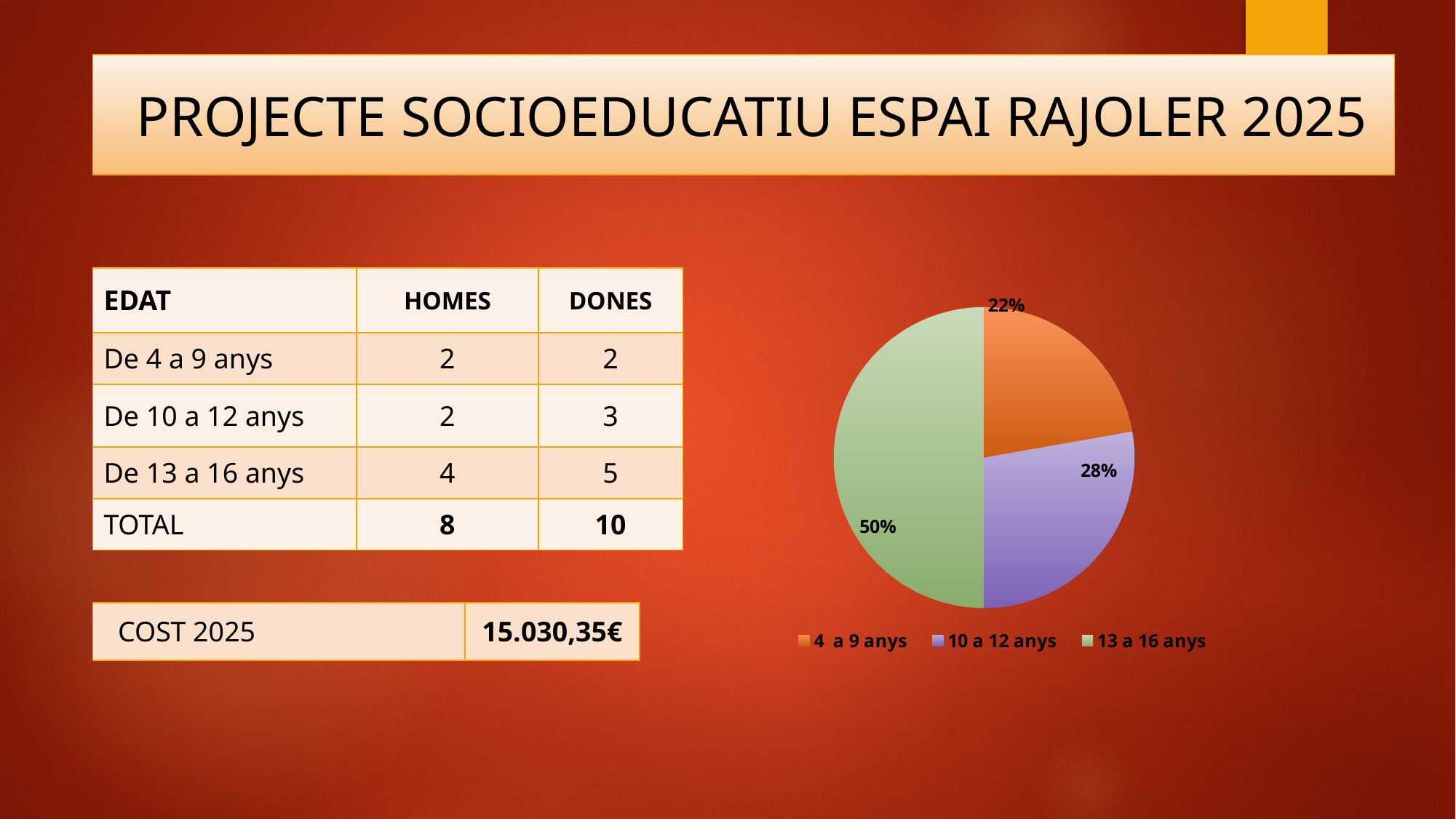
Which slice is larger, '10 a 12 anys' or '4 a 9 anys'? 10 a 12 anys Which age group has the smallest slice of the pie? 4 a 9 anys How many entries does the legend of the pie chart list? 3 What colour is the '13 a 16 anys' slice in the pie chart? green What share of the pie does the '10 a 12 anys' slice represent? 28% What share of the pie does the '13 a 16 anys' slice represent? 50% What share of the pie does the '4 a 9 anys' slice represent? 22% What is the difference in percentage points between the '10 a 12 anys' slice and the '4 a 9 anys' slice? 6% What kind of chart is shown on the slide? pie chart How many slices does the pie chart have? 3 Which age group has the largest slice of the pie? 13 a 16 anys What is the difference in percentage points between the '13 a 16 anys' slice and the '4 a 9 anys' slice? 28%